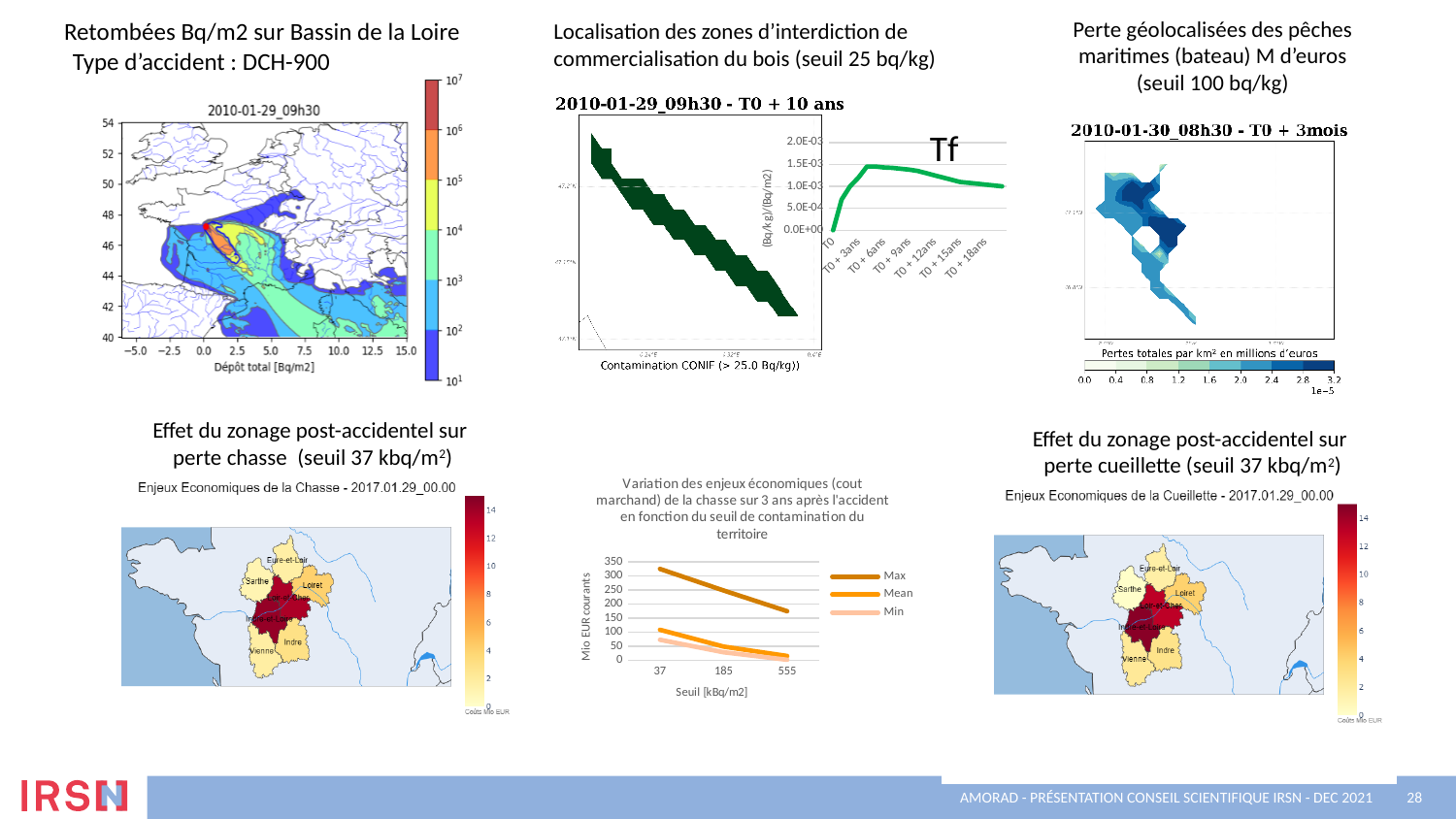
What are the series names in the legend of the 'Variation des enjeux économiques' line chart? Max, Mean, Min What is the y-axis label of the 'Variation des enjeux économiques' line chart? Mio EUR courants In the 'Variation des enjeux économiques' line chart, is the Max value at Seuil 37 greater or less than 300? greater How many threshold values (Seuil) are plotted along the x axis of the 'Variation des enjeux économiques' line chart? 3 How many series does the legend of the 'Variation des enjeux économiques' line chart list? 3 What kind of chart is the 'Variation des enjeux économiques (cout marchand) de la chasse' chart in the bottom centre of the slide? line chart In the 'Variation des enjeux économiques' line chart, do the Max values rise or fall as the Seuil increases from 37 to 555 kBq/m2? fall In the 'Variation des enjeux économiques' line chart, is the Max value at Seuil 555 greater or less than 200? less In the 'Variation des enjeux économiques' line chart, which series has the larger value at Seuil 37, Max or Min? Max In the 'Variation des enjeux économiques' line chart, is the Min value at Seuil 555 greater or less than 50? less